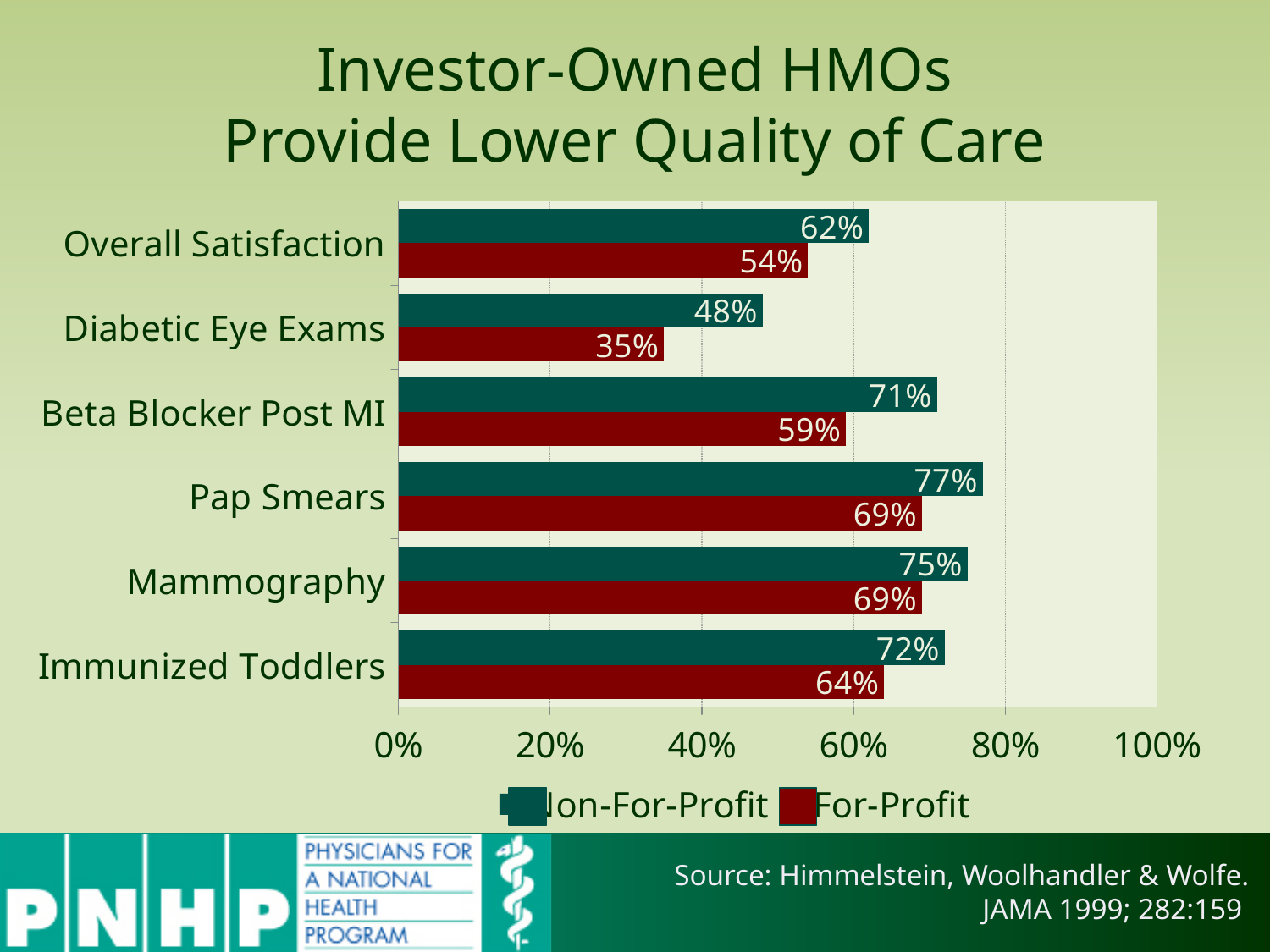
How many series does the legend list? 2 Which category has the highest Non-For-Profit value? Pap Smears What is the difference between the Non-For-Profit and For-Profit values for Beta Blocker Post MI? 12% What is the Non-For-Profit value for Pap Smears? 77% What kind of chart is shown on the slide? Bar chart Which category has the lowest For-Profit value? Diabetic Eye Exams What is the Non-For-Profit value for Beta Blocker Post MI? 71% What is the difference between the Non-For-Profit and For-Profit values for Diabetic Eye Exams? 13% How many categories are shown on the chart? 6 What is the For-Profit value for Overall Satisfaction? 54% What is the For-Profit value for Diabetic Eye Exams? 35% Which is larger: the Non-For-Profit value for Mammography or the Non-For-Profit value for Immunized Toddlers? Mammography